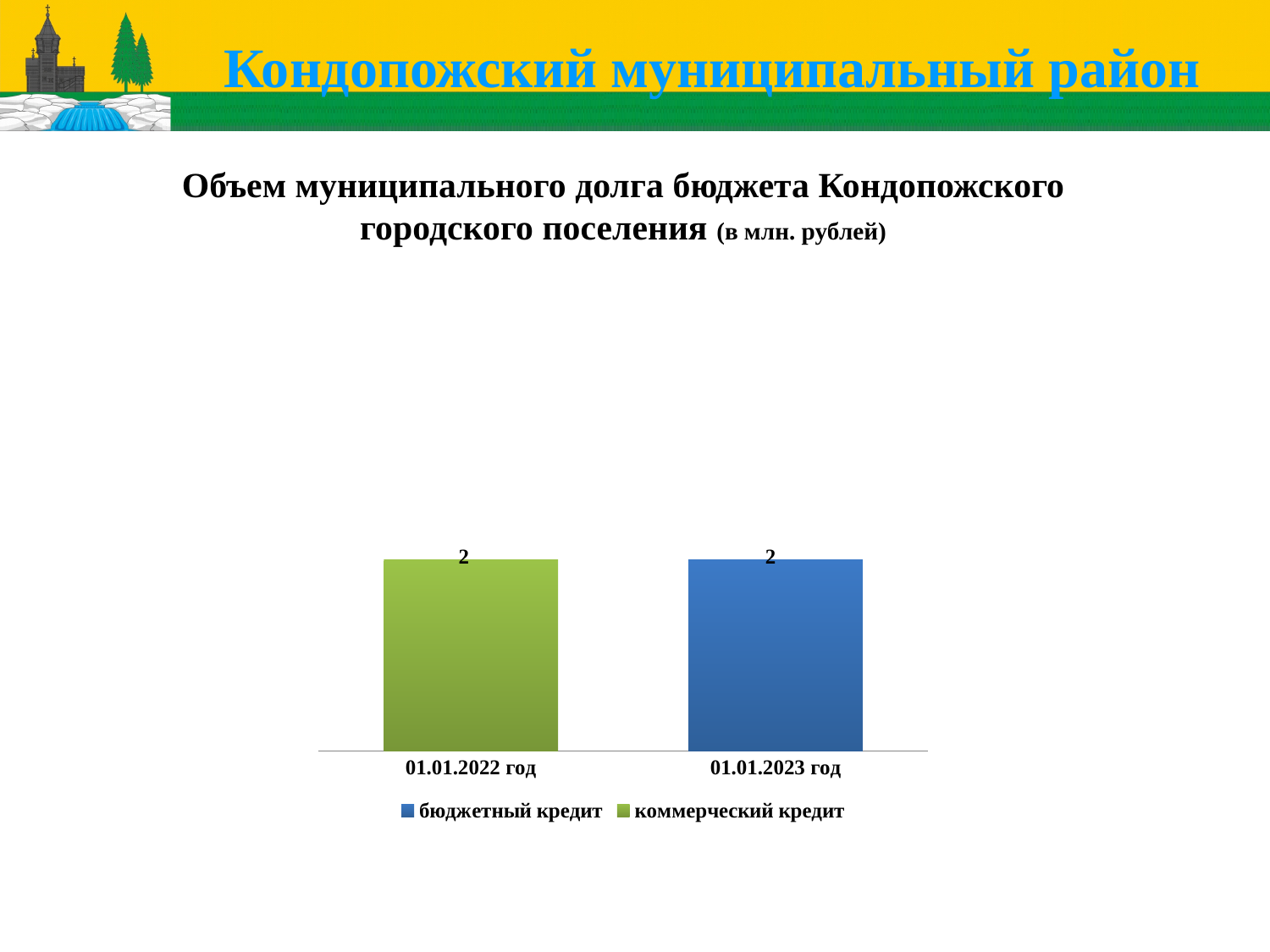
How many categories are shown on the x axis of the chart? 2 Which series does the green colour represent in the legend? коммерческий кредит What is the value shown for 01.01.2023 год? 2 What is the difference between the values for 01.01.2022 год and 01.01.2023 год? 0 What is the value shown for 01.01.2022 год? 2 Which series is plotted for 01.01.2023 год? бюджетный кредит What kind of chart is shown on the slide? bar chart Which series is plotted for 01.01.2022 год? коммерческий кредит Which series does the blue colour represent in the legend? бюджетный кредит How many series does the legend list? 2